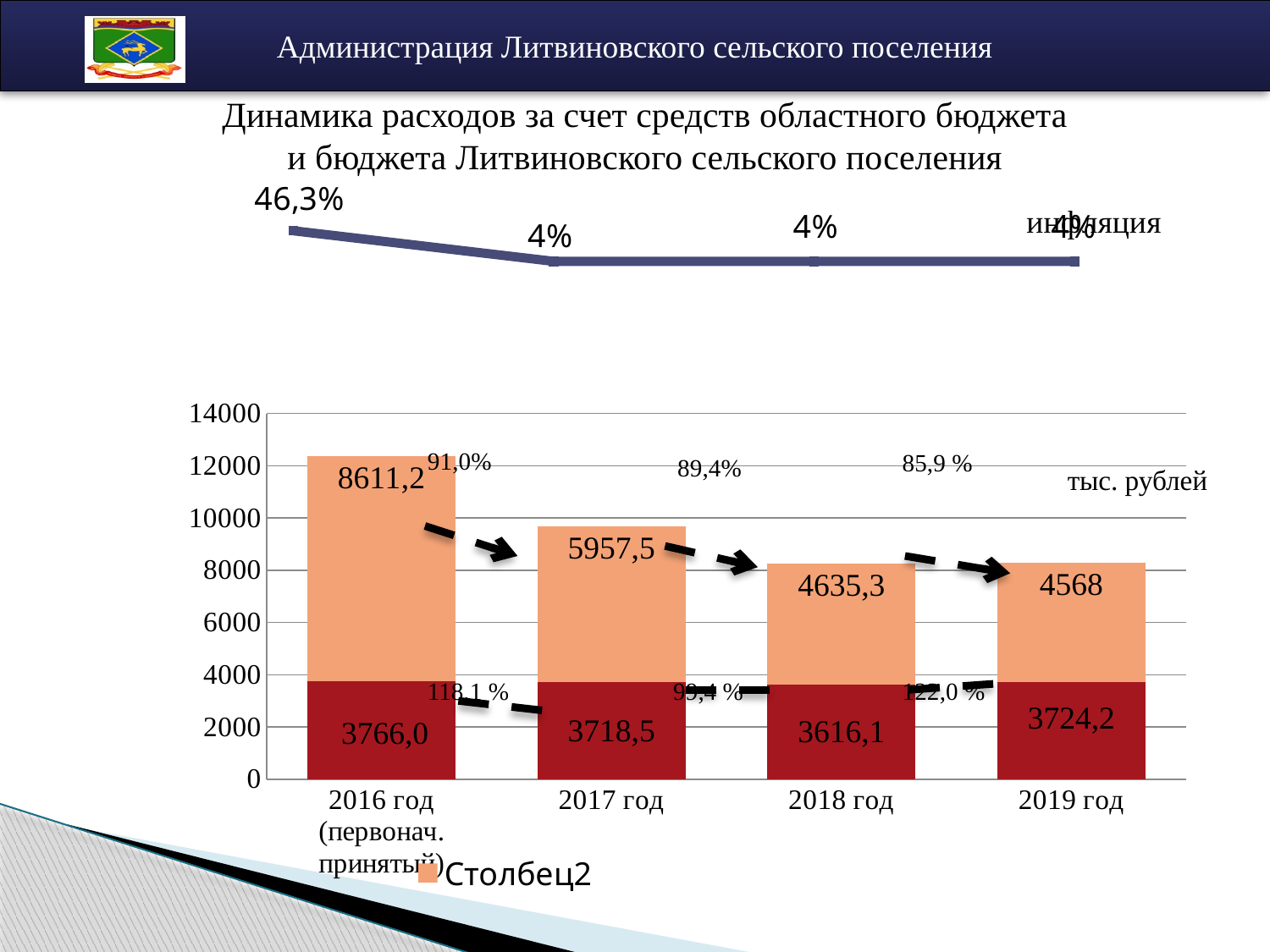
In the bar chart, what is the value of the dark red (lower) segment for 2019 год? 3724,2 In the bar chart, what is the value of the orange (upper) segment for 2016 год (первонач. принятый)? 8611,2 In the bar chart, do the orange (upper) segment values rise or fall from 2016 год to 2019 год? Fall In the bar chart, which year has the lowest value for the dark red (lower) segment? 2018 год In the bar chart, what is the total of the stacked bar for 2018 год? 8251,4 In the bar chart, which is larger: the dark red segment for 2017 год or for 2019 год? 2019 год In the bar chart, which year has the highest value for the orange (upper) segment? 2016 год (первонач. принятый) In the line chart at the top of the slide labelled инфляция, what is the first (leftmost) value shown? 46,3% In the bar chart, what is the difference between the orange segment values for 2016 год and 2017 год? 2653,7 In the bar chart, what is the total of the stacked bar for 2017 год? 9676,0 How many year categories are shown on the x axis of the bar chart? 4 What kind of chart is the lower chart on the slide? Stacked bar chart